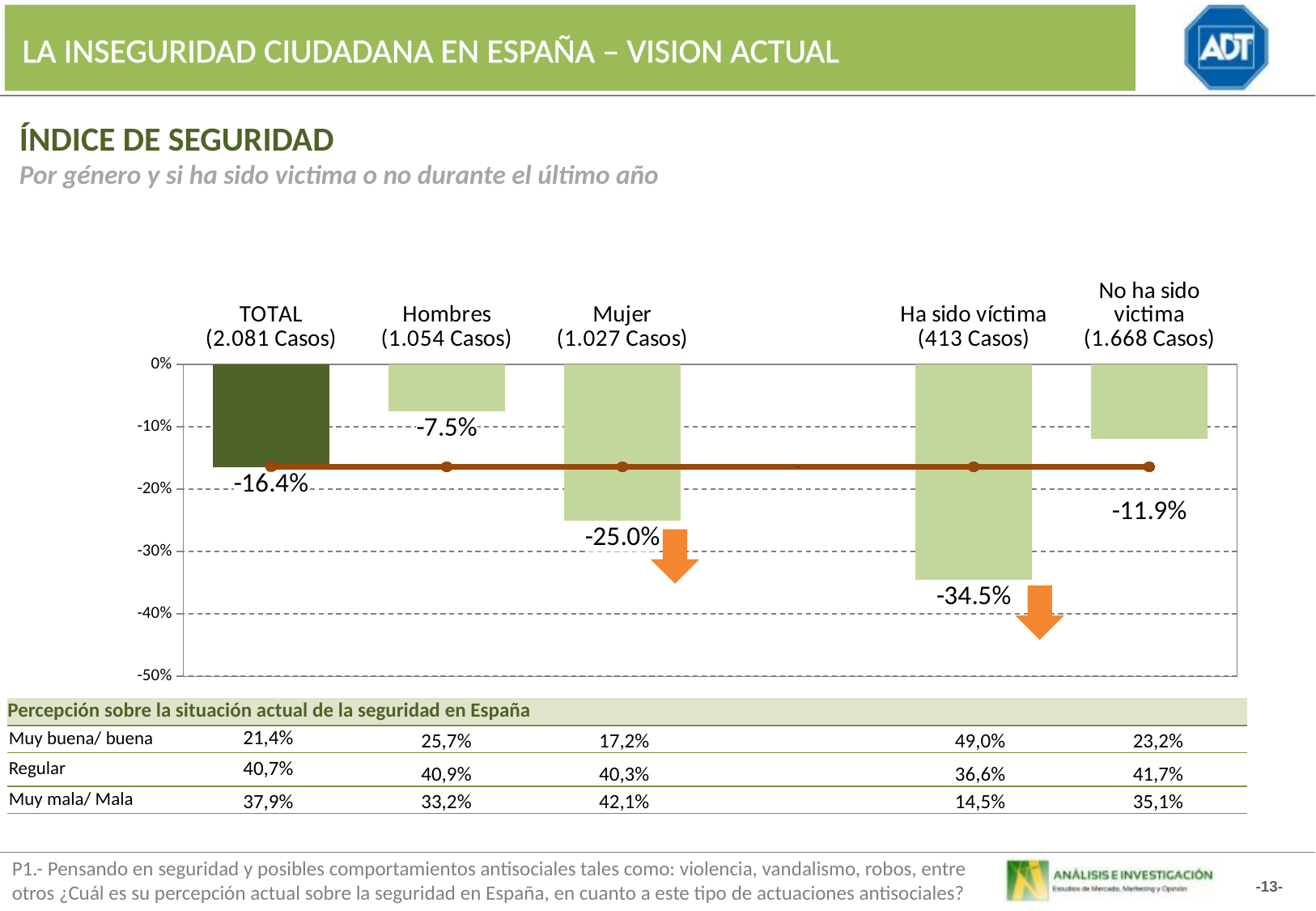
Which has a more negative security index value, Mujer or No ha sido víctima? Mujer What is the difference in percentage points between the values for Hombres and Mujer? 17.5 percentage points What is the security index value for No ha sido víctima (1.668 Casos)? -11.9% Which category has the lowest (most negative) security index value? Ha sido víctima What is the security index value for Hombres (1.054 Casos)? -7.5% What is the security index value for Ha sido víctima (413 Casos)? -34.5% What is the title of the chart section on the slide? ÍNDICE DE SEGURIDAD What is the security index value for Mujer (1.027 Casos)? -25.0% What is the security index value for TOTAL (2.081 Casos)? -16.4% What kind of chart is used to show the security index? Bar chart Which category has the highest (least negative) security index value? Hombres How many categories are plotted as bars in the chart? 5